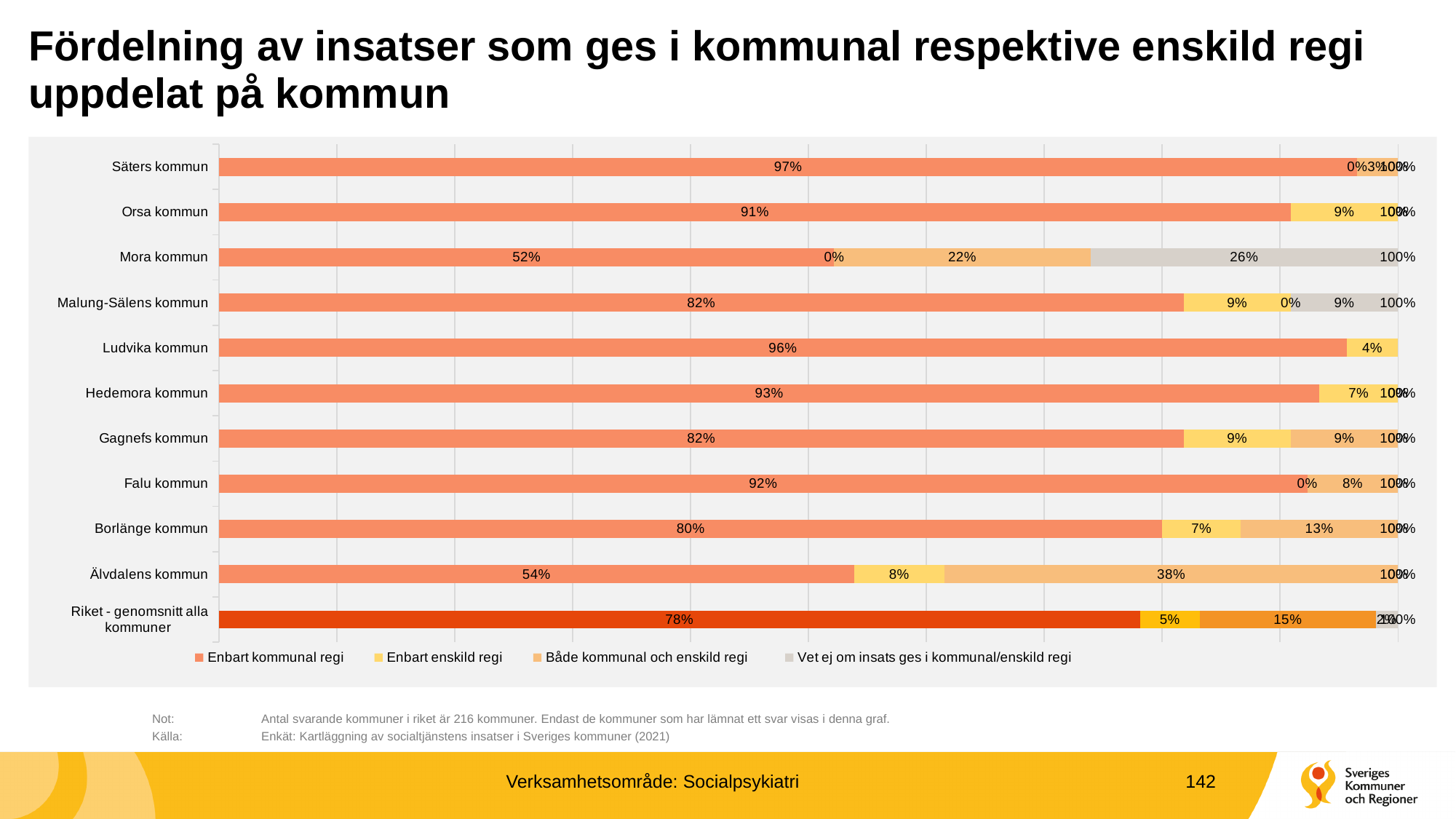
Which category has the highest value for 'Enbart kommunal regi'? Säters kommun Which has a larger 'Enbart kommunal regi' value, Borlänge kommun or Gagnefs kommun? Gagnefs kommun What is the value of 'Enbart kommunal regi' for Mora kommun? 52% What is the value of 'Enbart kommunal regi' for 'Riket - genomsnitt alla kommuner'? 78% How many categories (rows) are plotted in the chart? 11 Which category has the lowest value for 'Enbart kommunal regi'? Mora kommun What is the difference in 'Enbart kommunal regi' between Säters kommun and Mora kommun? 45 percentage points What is the value of 'Vet ej om insats ges i kommunal/enskild regi' for Mora kommun? 26% What is the value of 'Både kommunal och enskild regi' for Borlänge kommun? 13% How many series does the legend list? 4 What kind of chart is shown on the slide? Stacked bar chart What is the value of 'Både kommunal och enskild regi' for Älvdalens kommun? 38%